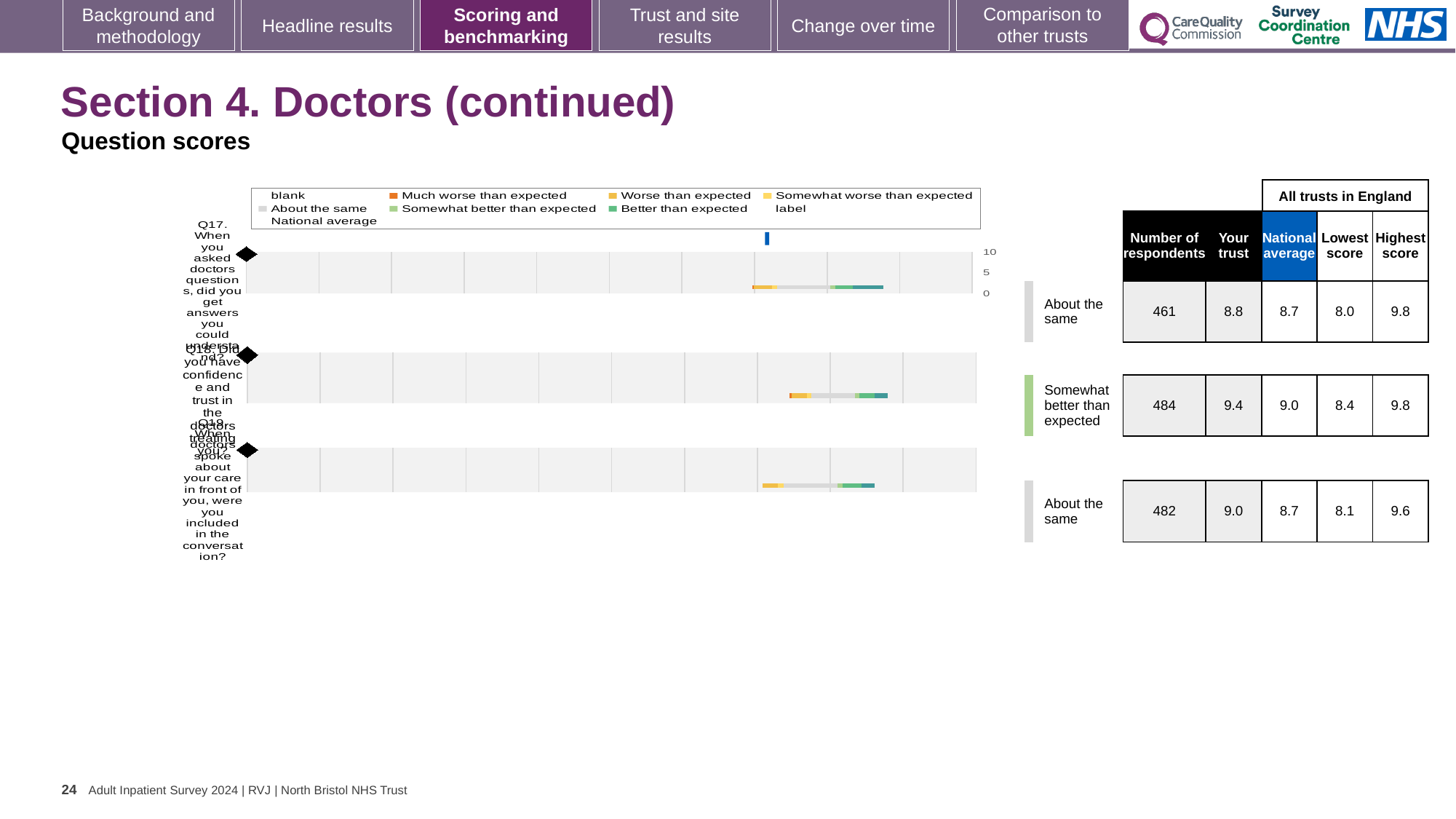
What is the highest score across all trusts in England for Q19? 9.6 What is the national average score for Q18 (Did you have confidence and trust in the doctors treating you)? 9.0 What is the 'Your trust' score for Q17 (When you asked doctors questions, did you get answers you could understand)? 8.8 What is the difference between the 'Your trust' score and the national average for Q18? 0.4 What kind of chart is used to show the question scores? Bar chart For Q19, which is larger: the 'Your trust' score or the national average? Your trust How many questions are plotted on the chart? 3 What is the maximum value shown on the chart's score axis? 10 What benchmark category is shown for Q18? Somewhat better than expected Which question has the lowest 'Lowest score' across all trusts in England? Q17 Which question has the highest 'Your trust' score? Q18 How many respondents answered Q19 (When doctors spoke about your care in front of you, were you included in the conversation)? 482